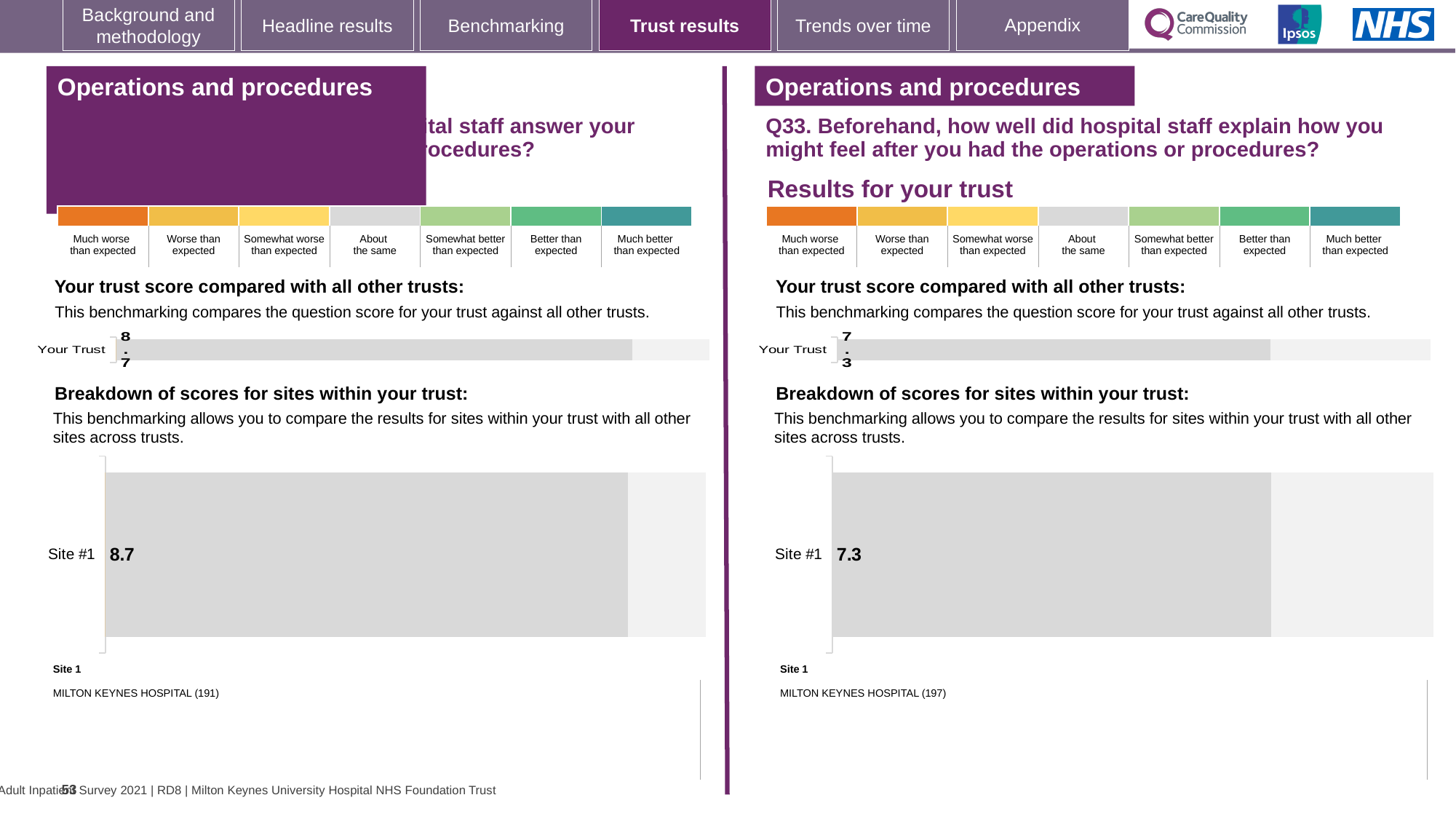
Which question number is the right panel's chart about? Q33 How many bars are shown in the left panel's 'Your trust score compared with all other trusts' chart? 1 What is the difference between the Site #1 score on the left panel and the Site #1 score on the right panel? 1.4 Which hospital is listed as Site 1 on the right panel? MILTON KEYNES HOSPITAL (197) On the right panel's 'Your trust score compared with all other trusts' chart, what is the value for Your Trust? 7.3 What kind of chart is used to show the Site #1 score on the right panel? Bar chart On the left panel's 'Breakdown of scores for sites within your trust' chart, what is the value for Site #1? 8.7 Which is larger: the Your Trust score on the left panel or the Your Trust score on the right panel (Q33)? Left panel On the left panel's 'Your trust score compared with all other trusts' chart, what is the value for Your Trust? 8.7 How many sites are shown in the right panel's 'Breakdown of scores for sites within your trust' chart? 1 On the right panel's 'Breakdown of scores for sites within your trust' chart, what is the value for Site #1? 7.3